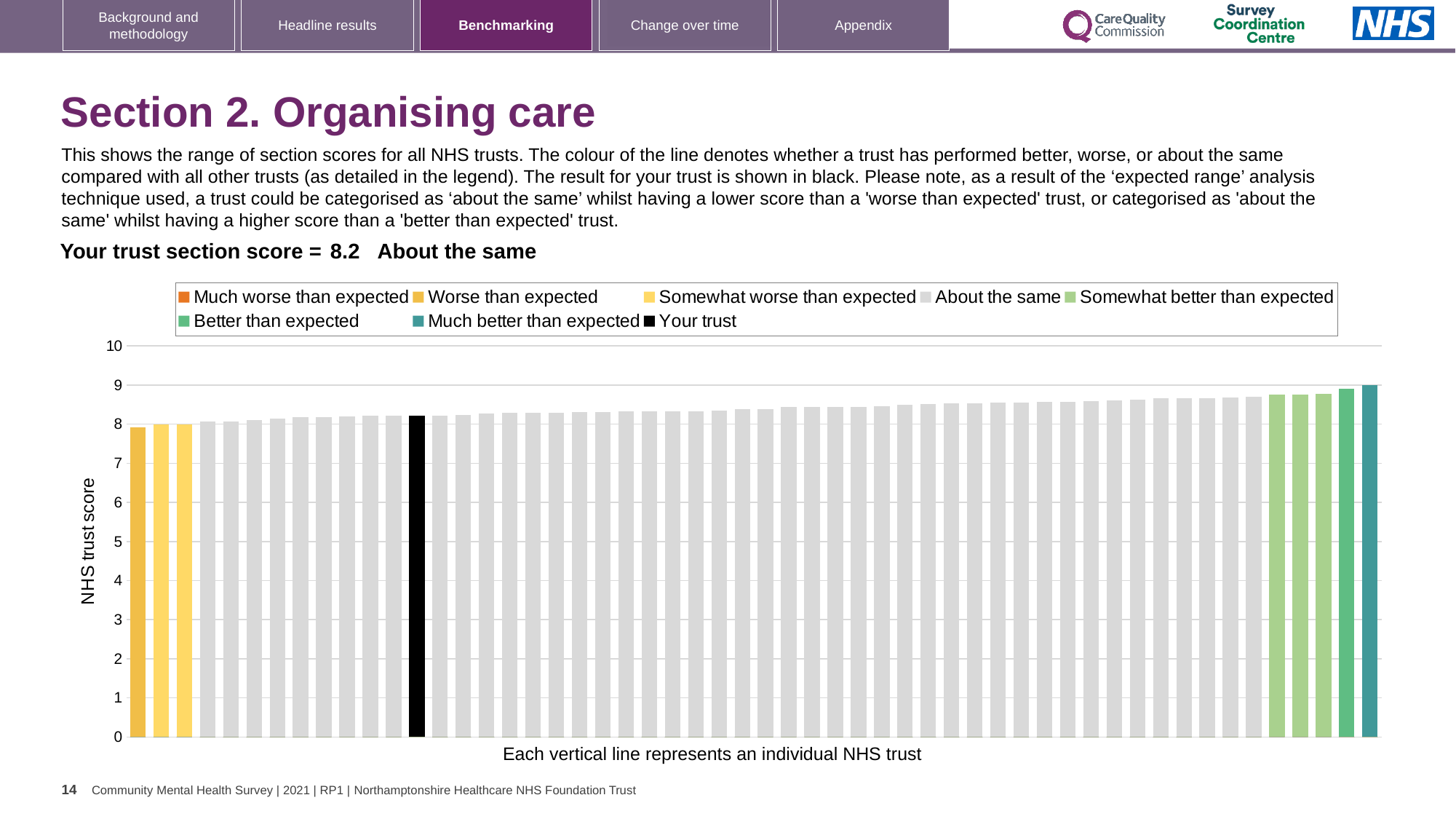
What is the section score for your trust shown on the slide? 8.2 What colour is the bar representing your trust? black Is the bar for your trust higher or lower than the tallest bar on the chart? lower Which legend category does the tallest bar belong to? Much better than expected How many entries does the chart legend list? 8 Is the value for your trust (the black bar) greater or less than 8? greater Is the value of the tallest bar greater or less than 8? greater What is the title of the vertical axis? NHS trust score Is the value of the shortest bar greater or less than 7? greater Do the bar values rise or fall from left to right along the x axis? rise Which legend category does the shortest bar belong to? Worse than expected What kind of chart is shown on the slide? bar chart